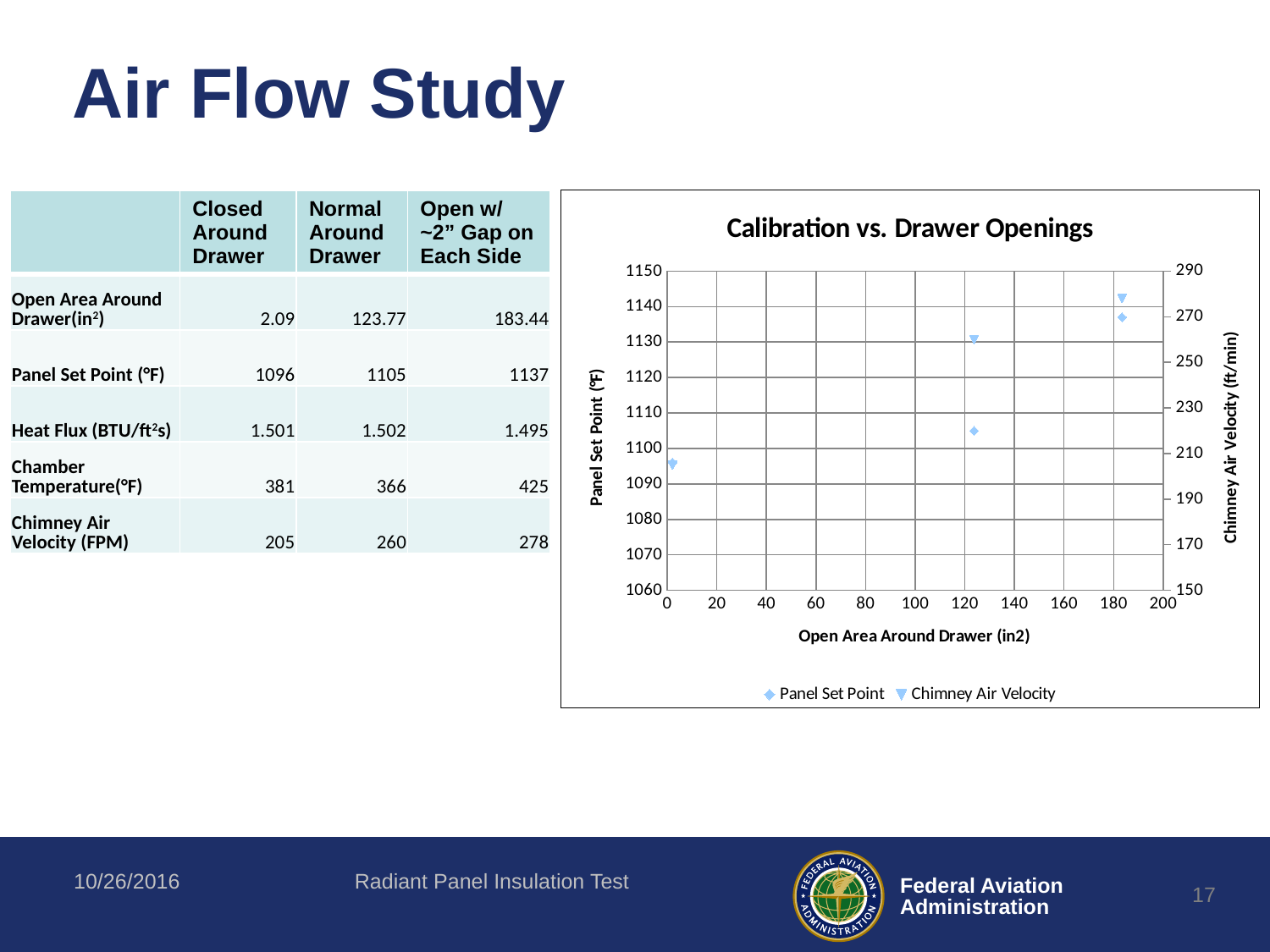
What type of chart is shown on the slide? scatter chart How many data points are plotted for the Panel Set Point series? 3 Is the Chimney Air Velocity value at an open area of about 120 in2 greater or less than 250? greater What is the title of the chart? Calibration vs. Drawer Openings Is the Panel Set Point value at an open area near 0 in2 greater or less than 1100? less Is the Panel Set Point value at an open area of about 120 in2 greater or less than 1110? less What is the label of the right-hand vertical axis? Chimney Air Velocity (ft/min) Which is larger: the Panel Set Point at an open area of about 180 in2 or at about 120 in2? about 180 in2 Do the Chimney Air Velocity values rise or fall as the open area around the drawer increases? rise How many series does the chart legend list? 2